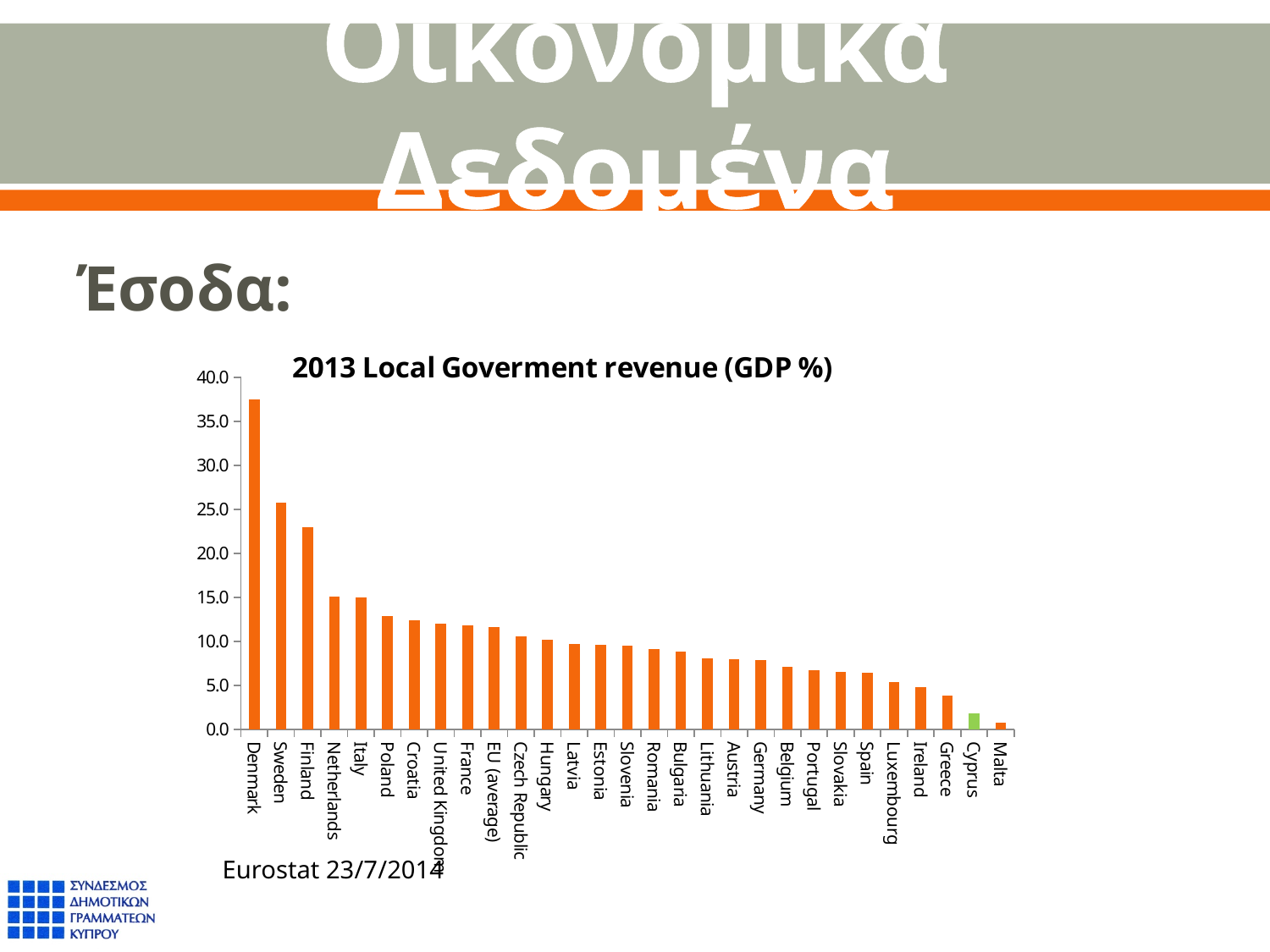
Is the value for Finland greater or less than 25.0? less Is the value for France greater or less than 10.0? greater What kind of chart is shown on the slide? bar chart How many categories are plotted on the x axis of the chart? 29 Is the value for Greece greater or less than 5.0? less Do the values rise or fall moving from left to right along the x axis? fall Which country has the lowest local government revenue as a percentage of GDP? Malta What is the title of the chart? 2013 Local Goverment revenue (GDP %) Which country's bar is shown in a different colour (green) from the others? Cyprus Which country has the highest local government revenue as a percentage of GDP? Denmark Which has a higher value, Sweden or Finland? Sweden